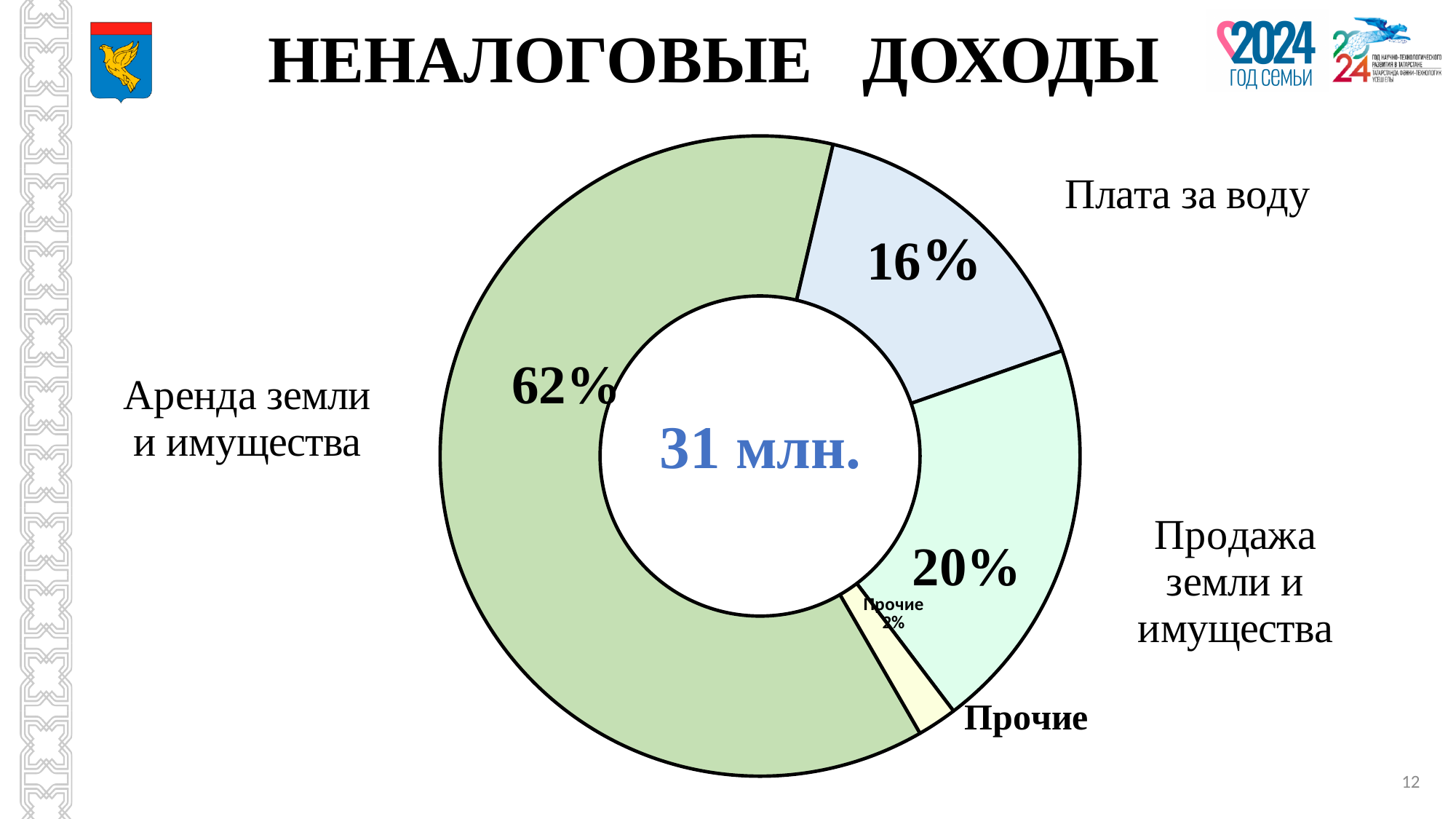
Which category has the smallest share of non-tax revenues? Прочие What share of non-tax revenues comes from Прочие? 2% What is the title of the slide? НЕНАЛОГОВЫЕ ДОХОДЫ Which category has the largest share of non-tax revenues? Аренда земли и имущества What total amount is shown in the centre of the chart? 31 млн. Which is larger: the share for Плата за воду or the share for Продажа земли и имущества? Продажа земли и имущества What share of non-tax revenues comes from Плата за воду? 16% What share of non-tax revenues comes from Аренда земли и имущества? 62% What is the difference in percentage points between Аренда земли и имущества and Продажа земли и имущества? 42 What kind of chart is shown on the slide? Doughnut (pie) chart How many categories are shown in the chart? 4 What share of non-tax revenues comes from Продажа земли и имущества? 20%